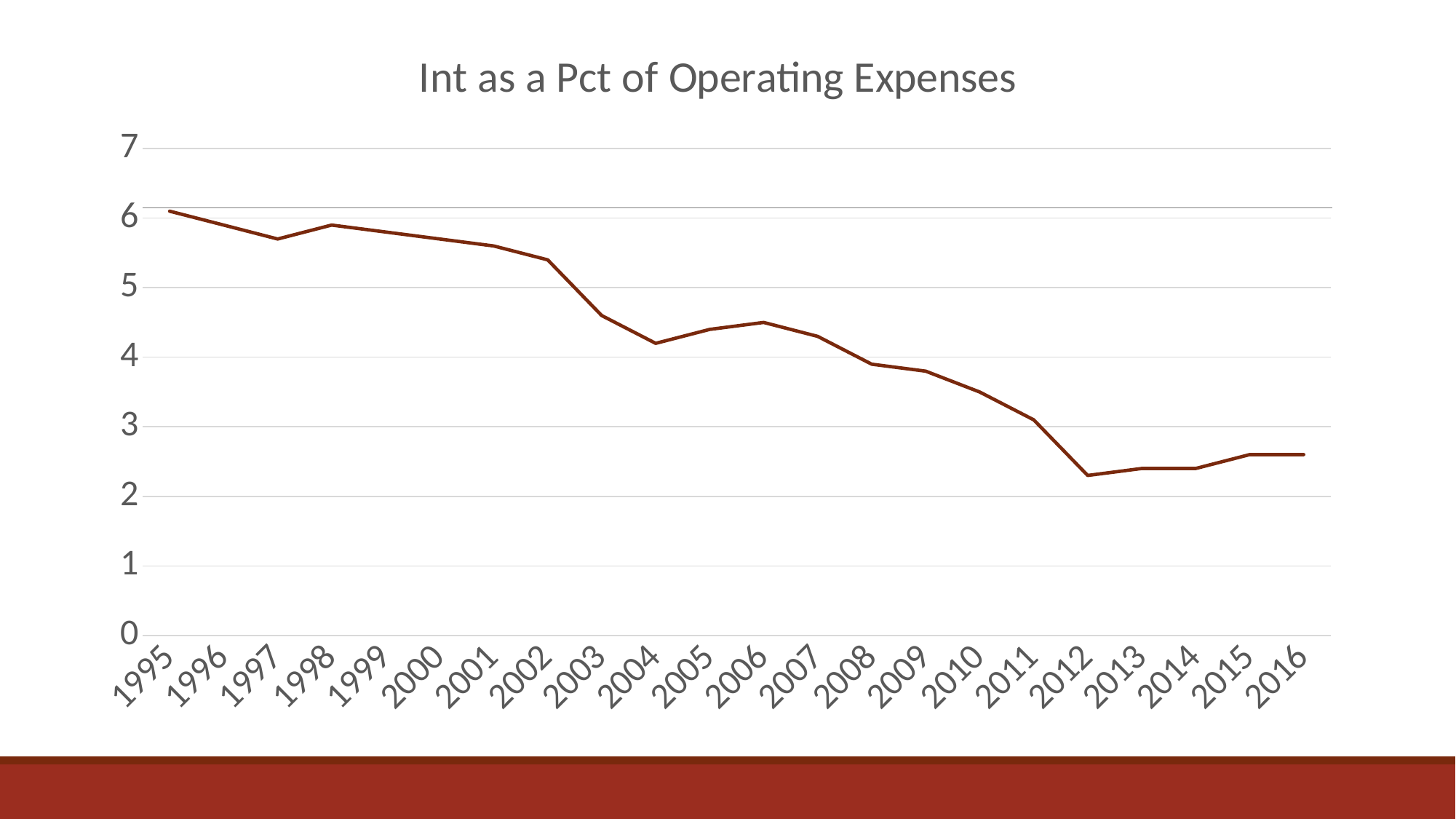
Is the value for 2004 greater or less than 4? greater How many years are plotted along the x axis? 22 Which year has the highest value? 1995 Is the value for 2003 greater or less than 5? less Is the value for 2002 greater or less than 5? greater Which is larger, the value for 2006 or the value for 2004? 2006 What kind of chart is shown on the slide? line chart Overall, do the values rise or fall from 1995 to 2016? fall Which is larger, the value for 1995 or the value for 2016? 1995 What is the title of the chart? Int as a Pct of Operating Expenses Which year has the lowest value? 2012